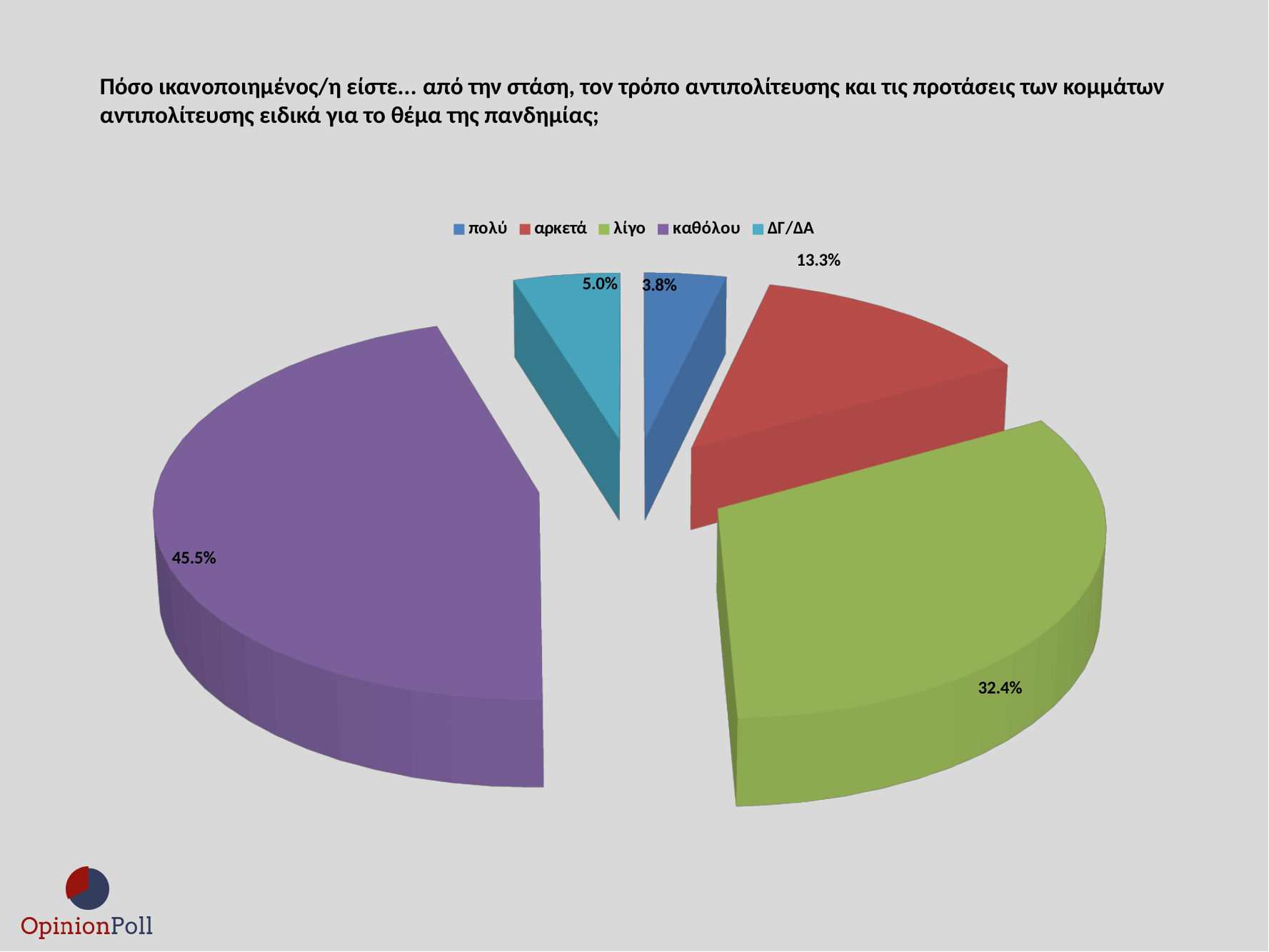
Which response has the smallest share of the pie? πολύ What percentage of respondents answered "αρκετά"? 13.3% What percentage of respondents answered "ΔΓ/ΔΑ"? 5.0% Which is larger, the share for "αρκετά" or the share for "ΔΓ/ΔΑ"? αρκετά What is the difference in percentage points between "καθόλου" and "λίγο"? 13.1 What percentage of respondents answered "καθόλου"? 45.5% How many categories does the legend list? 5 What percentage of respondents answered "πολύ"? 3.8% Which response has the largest share of the pie? καθόλου What percentage of respondents answered "λίγο"? 32.4% What colour is the slice for "λίγο"? Green What kind of chart is shown on the slide? Pie chart